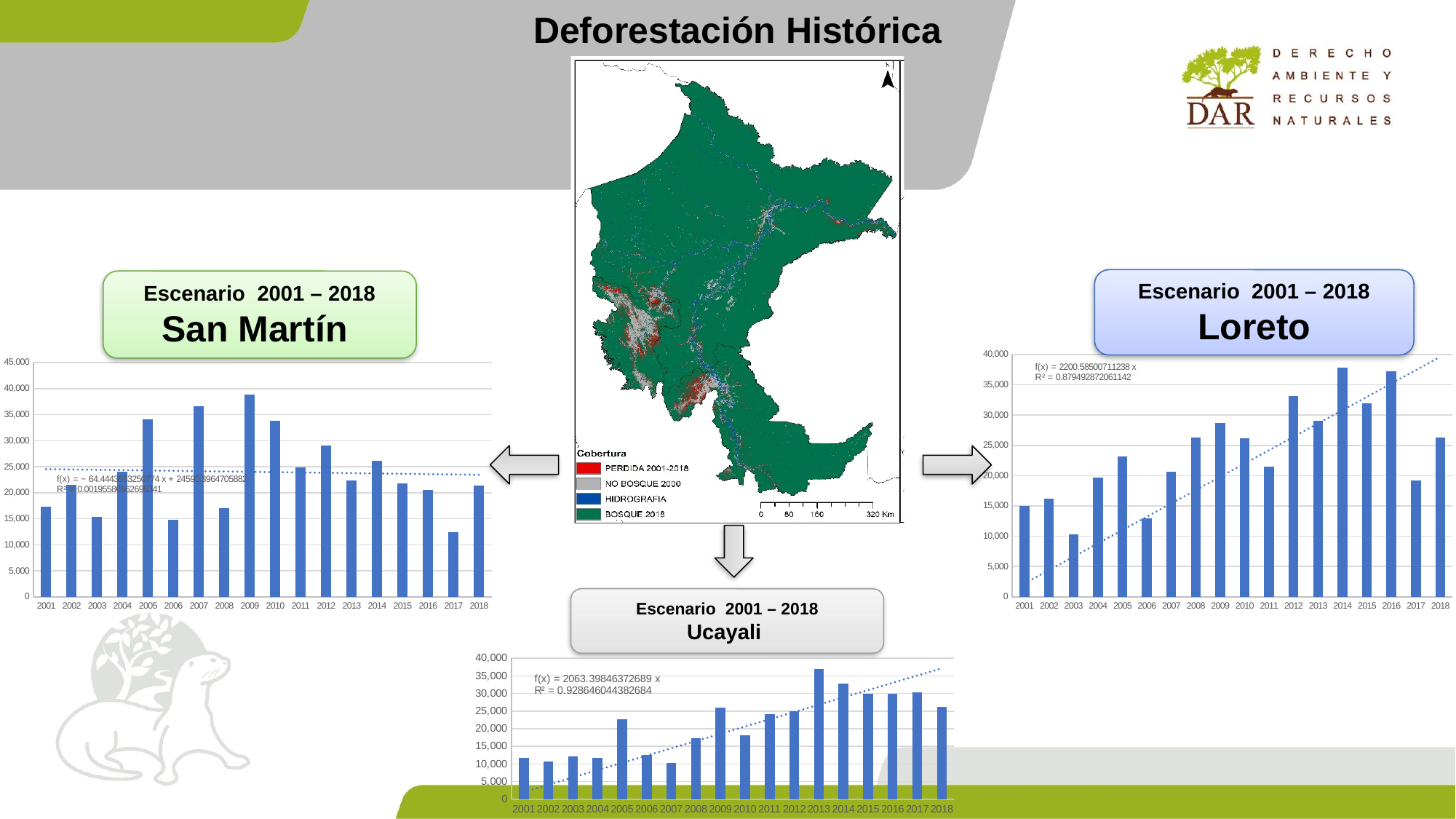
In the Loreto chart, which is larger, the value for 2001 or the value for 2008? 2008 How many years are plotted in the San Martín chart? 18 In the San Martín chart, is the value for 2017 greater or less than 15,000? less What kind of chart is the San Martín chart? bar chart In the San Martín chart, which year has the lowest value? 2017 In the Ucayali chart, is the value for 2009 greater or less than 20,000? greater In the Loreto chart, which year has the lowest value? 2003 In the San Martín chart, which year has the highest value? 2009 In the Ucayali chart, which year has the highest value? 2013 In the San Martín chart, is the value for 2005 greater or less than 30,000? greater In the Loreto chart, do the values generally rise or fall from 2001 to 2018? rise